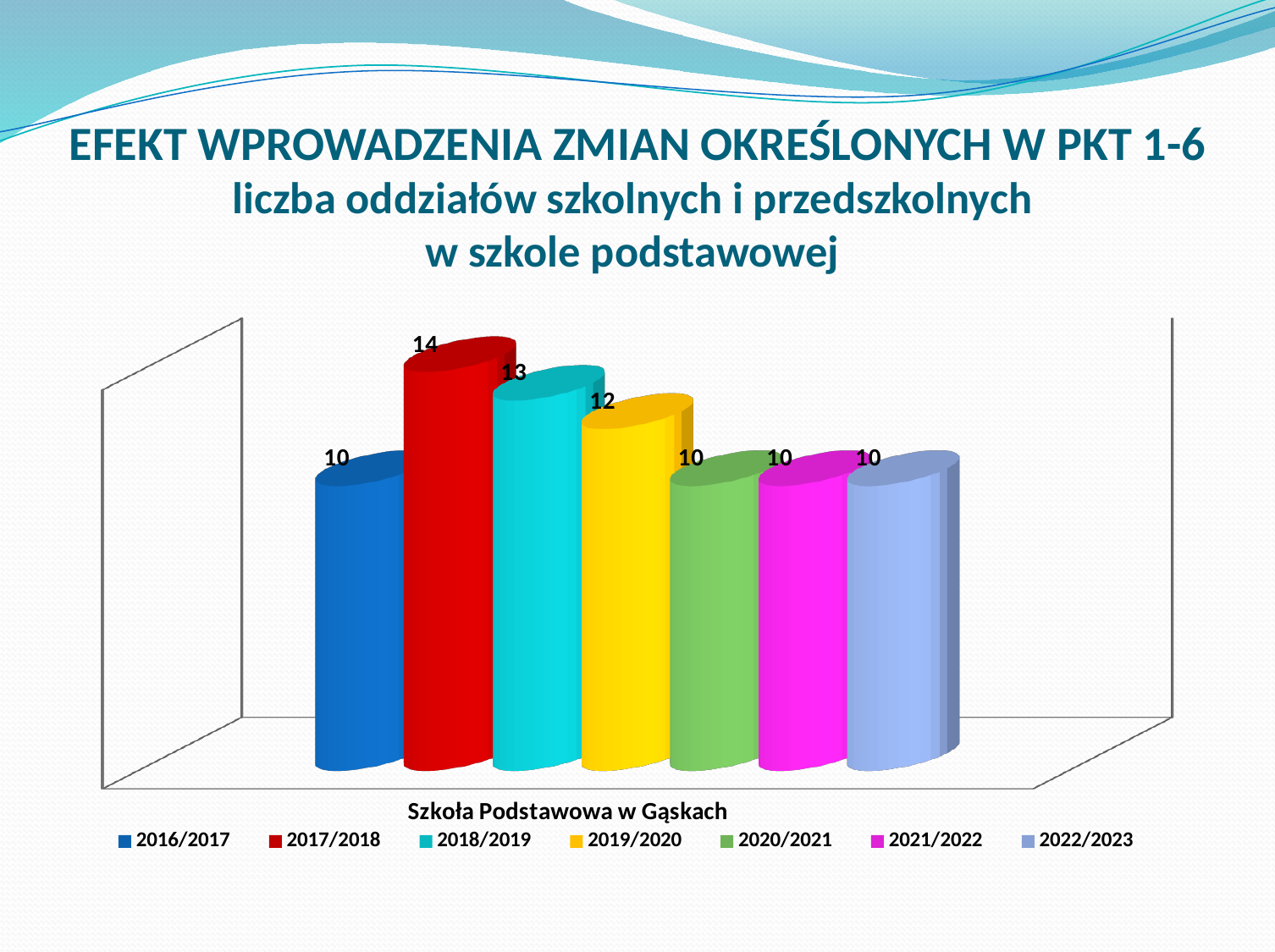
What kind of chart is shown on the slide? bar chart How many series does the legend list? 7 What is the difference between the 2017/2018 value and the 2019/2020 value? 2 What is the value for the 2022/2023 series? 10 What is the value for the 2018/2019 series? 13 Which is larger, the value for 2018/2019 or the value for 2020/2021? 2018/2019 What is the category label shown on the x axis? Szkoła Podstawowa w Gąskach Which series has the highest value? 2017/2018 What is the value for the 2019/2020 series? 12 What is the value for the 2017/2018 series? 14 What is the difference between the 2018/2019 value and the 2016/2017 value? 3 What is the value for the 2016/2017 series? 10